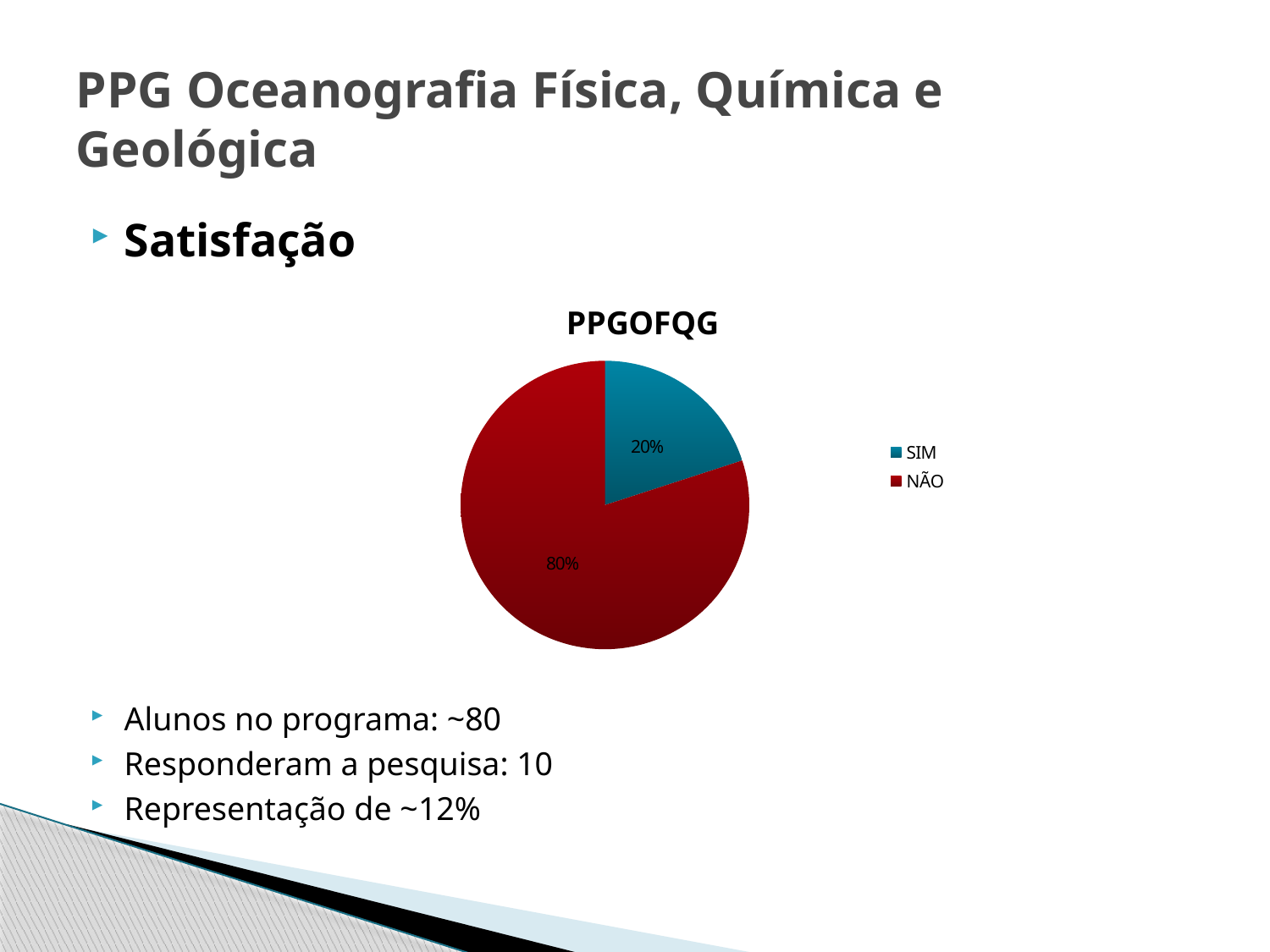
What is the difference in percentage points between the NÃO slice and the SIM slice? 60 percentage points What is the chart's title? PPGOFQG What colour is the NÃO slice? red How many slices does the pie chart have? 2 Which is larger, the SIM slice or the NÃO slice? NÃO What share of the pie does the SIM slice represent? 20% Which slice is the smallest? SIM Which slice is the largest? NÃO How many entries does the legend list? 2 What share of the pie does the NÃO slice represent? 80% What kind of chart is shown on the slide? pie chart